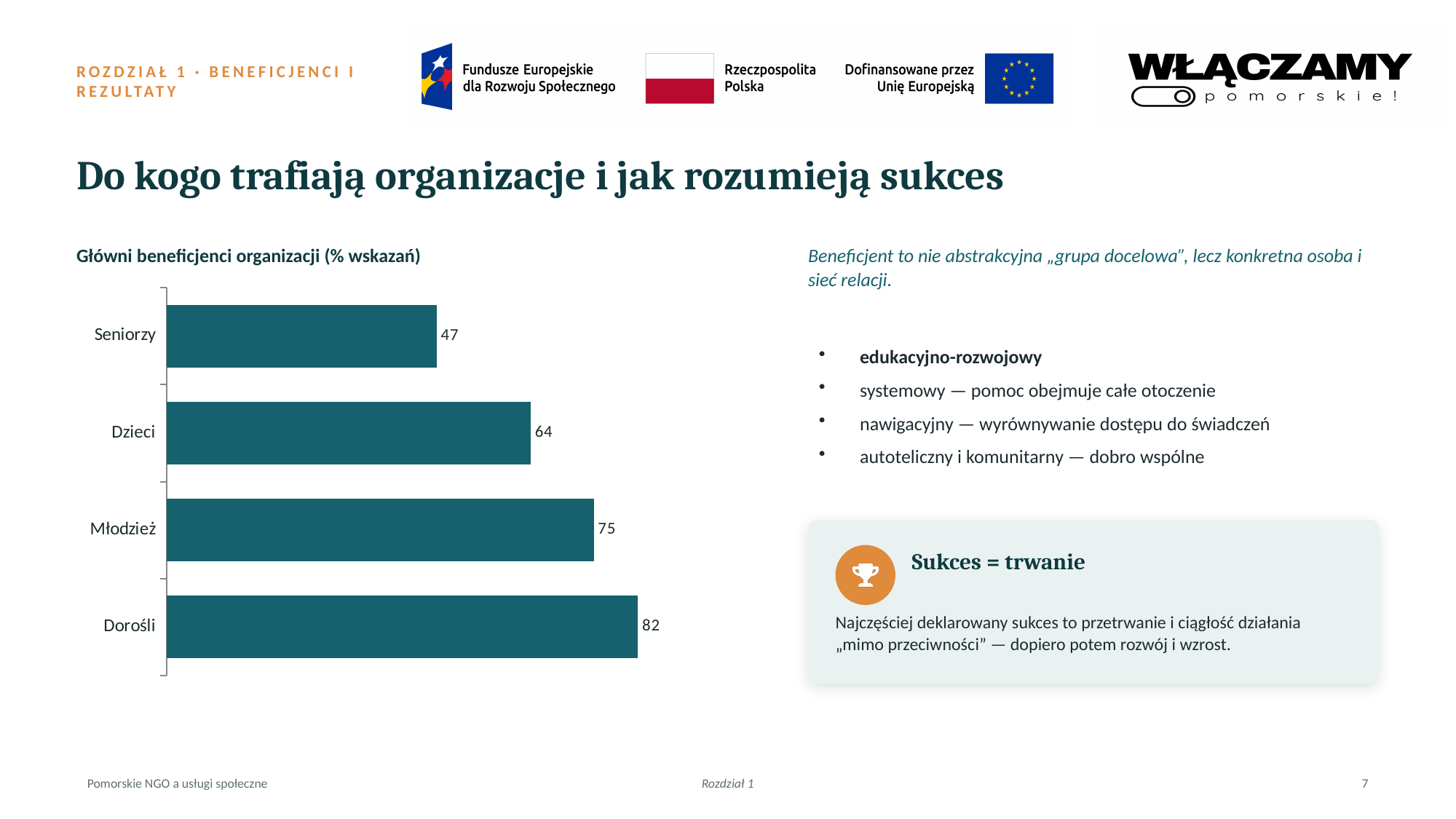
What is the value for Dorośli in the chart? 82 Which category has the highest value in the chart? Dorośli What is the value for Seniorzy in the chart? 47 What is the difference between the values for Młodzież and Dzieci? 11 What kind of chart is shown on the slide? Bar chart How many categories are shown in the chart? 4 What is the value for Dzieci in the chart? 64 What is the title of the chart? Główni beneficjenci organizacji (% wskazań) Which category has the lowest value in the chart? Seniorzy What is the value for Młodzież in the chart? 75 What is the difference between the values for Dorośli and Seniorzy? 35 Which has a larger value, Dzieci or Młodzież? Młodzież